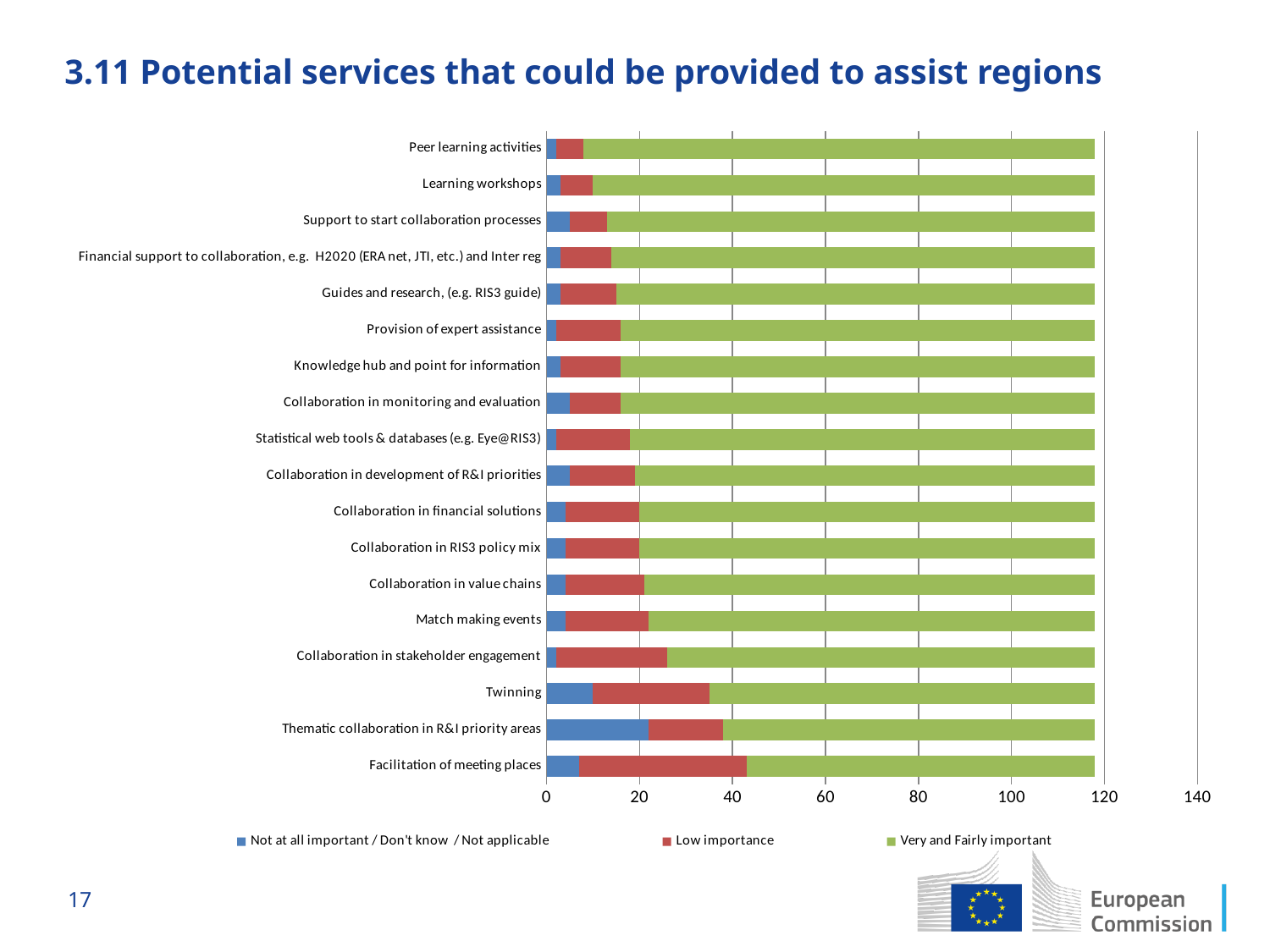
What are the three legend entries of the chart? Not at all important / Don't know / Not applicable; Low importance; Very and Fairly important How many service categories are plotted on the chart? 18 Is the 'Not at all important / Don't know / Not applicable' value for 'Twinning' greater or less than 20? less What kind of chart is shown on the slide? Stacked bar chart Moving from the top category to the bottom category, do the 'Low importance' segments generally get longer or shorter? longer Is the 'Very and Fairly important' value for 'Peer learning activities' greater or less than 100? greater Which colour represents the 'Very and Fairly important' series? Green Is the total bar length for 'Facilitation of meeting places' greater or less than 100? greater How many series does the legend list? 3 Which category has the largest 'Low importance' segment? Facilitation of meeting places Which category has the larger 'Not at all important / Don't know / Not applicable' segment: 'Thematic collaboration in R&I priority areas' or 'Twinning'? Thematic collaboration in R&I priority areas Which category has the larger 'Very and Fairly important' segment: 'Peer learning activities' or 'Facilitation of meeting places'? Peer learning activities